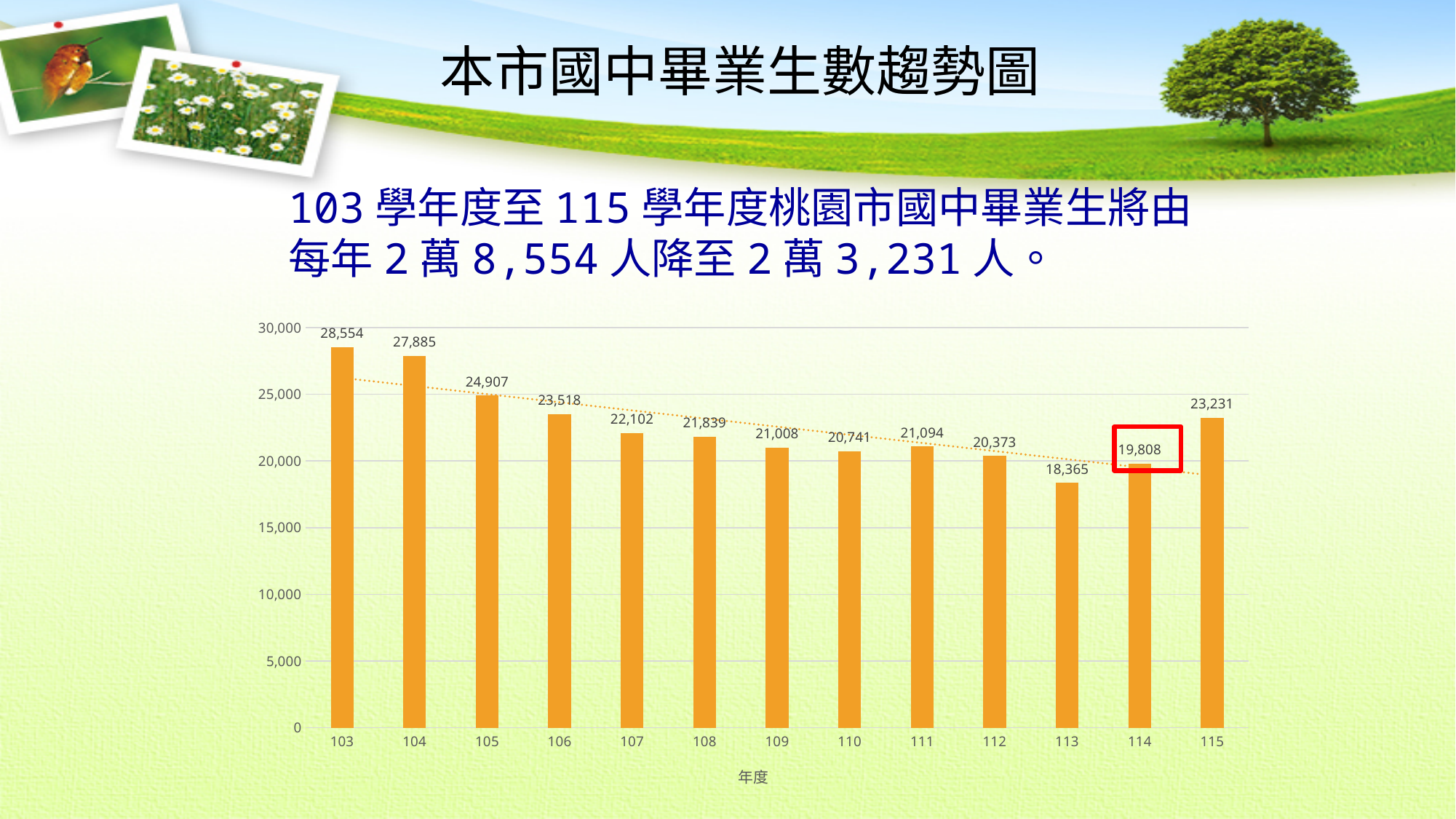
Which is larger, the value for year 111 or the value for year 110? 111 What is the value for year 103? 28,554 What is the value highlighted by the red box, for year 114? 19,808 Which year has the lowest number of graduates? 113 Which year has the highest number of graduates? 103 What is the value for year 113? 18,365 What is the difference between the values for year 103 and year 115? 5,323 What is the x-axis title of the chart? 年度 What kind of chart is this? bar chart What is the difference between the values for year 114 and year 113? 1,443 How many years are shown on the x axis? 13 What is the value for year 115? 23,231